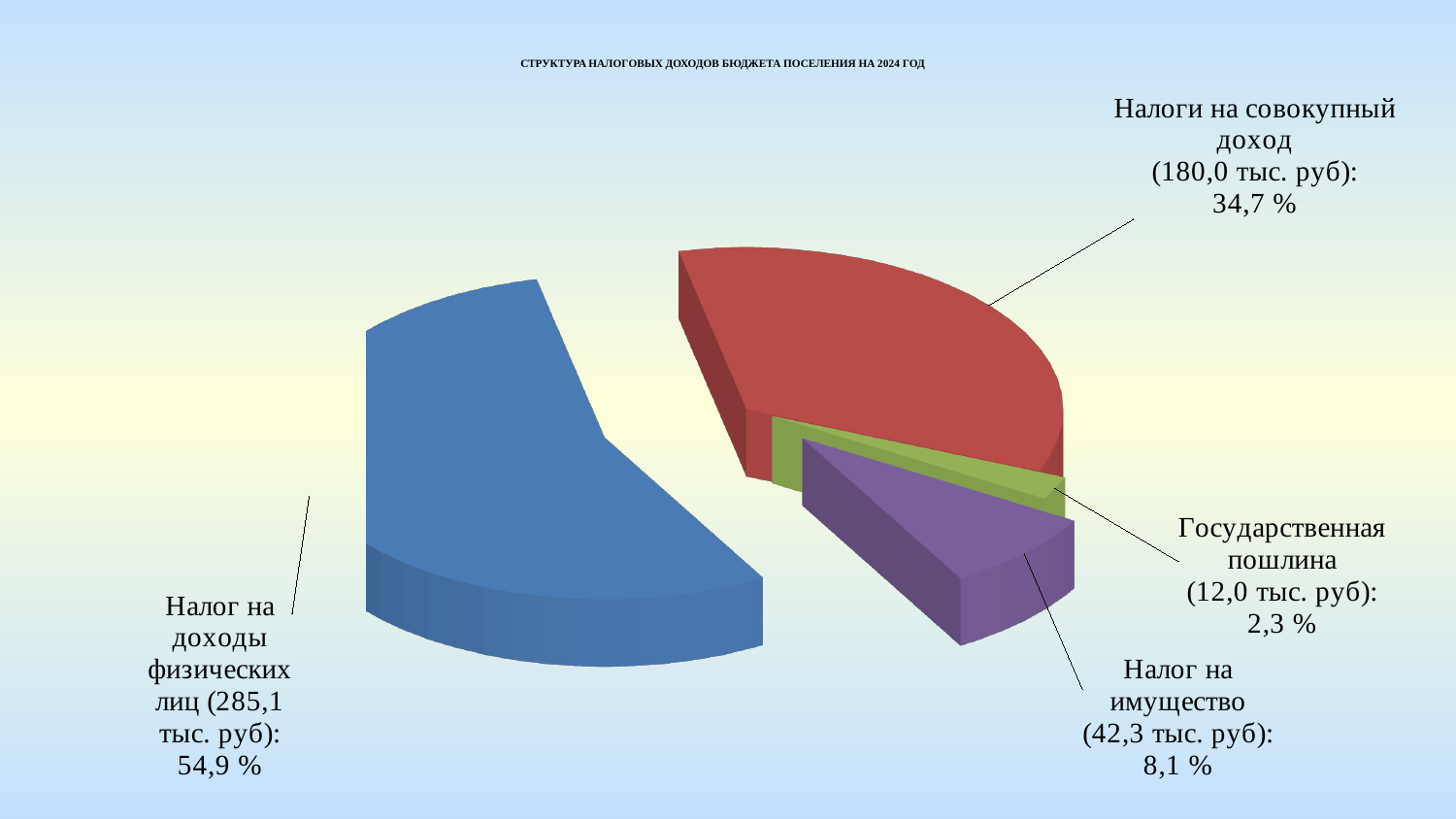
How many slices does the pie chart have? 4 Which is larger: Налог на имущество or Государственная пошлина? Налог на имущество What type of chart is shown on the slide? Pie chart Which category has the largest slice of the pie? Налог на доходы физических лиц What is the value in тыс. руб for Налог на имущество? 42,3 тыс. руб What share of the pie does Налог на доходы физических лиц represent? 54,9 % What is the title of the chart? СТРУКТУРА НАЛОГОВЫХ ДОХОДОВ БЮДЖЕТА ПОСЕЛЕНИЯ НА 2024 ГОД What is the value in тыс. руб for Налоги на совокупный доход? 180,0 тыс. руб Which category has the smallest slice of the pie? Государственная пошлина What colour is the slice for Налог на имущество? Purple What share of the pie does Государственная пошлина represent? 2,3 % What is the difference in тыс. руб between Налог на доходы физических лиц and Налоги на совокупный доход? 105,1 тыс. руб